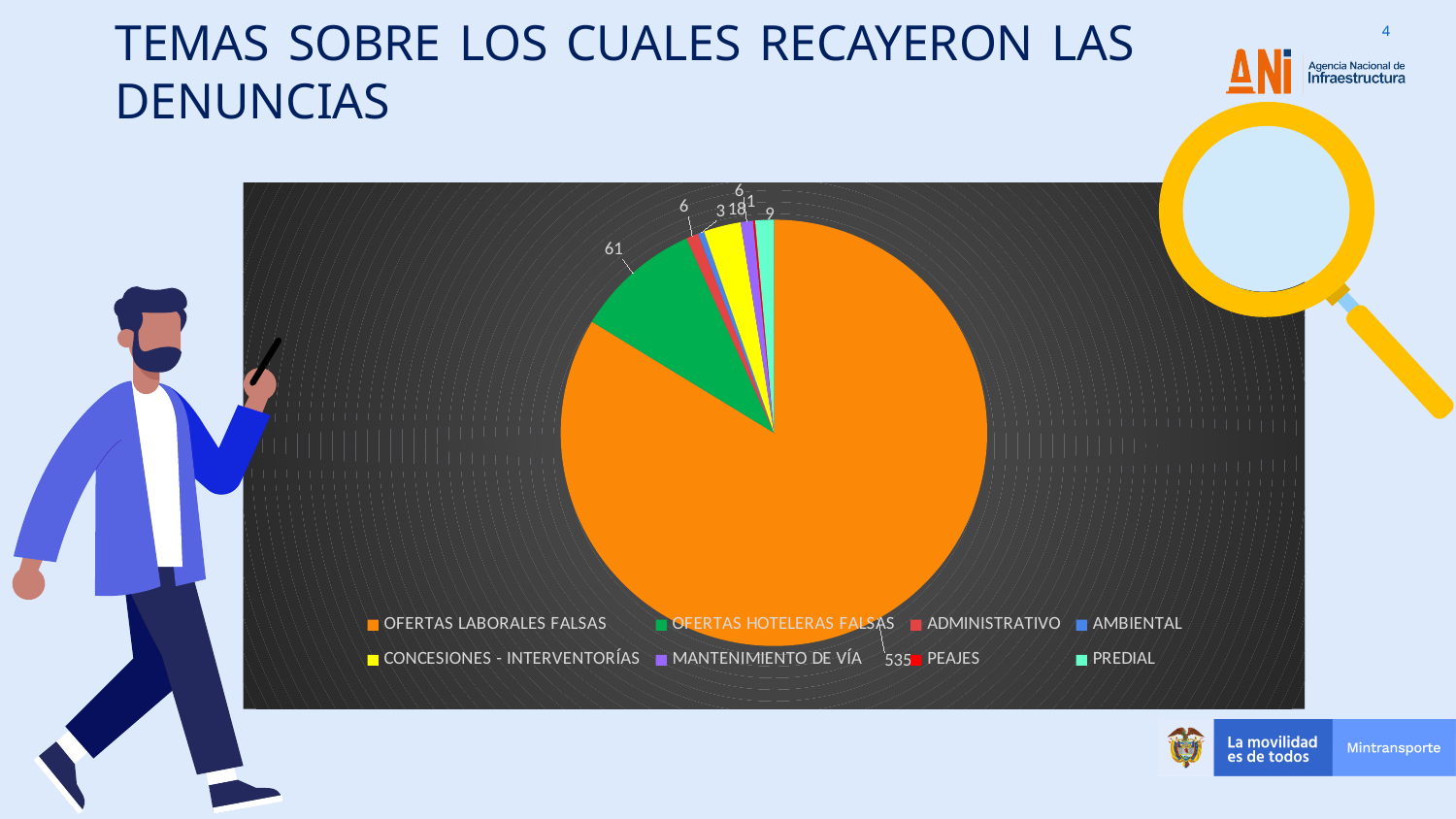
How many categories does the legend of the pie chart list? 8 What is the value for PREDIAL? 9 Which category has the smallest value in the pie chart? PEAJES What is the difference between the values for OFERTAS LABORALES FALSAS and OFERTAS HOTELERAS FALSAS? 474 What kind of chart is shown on the slide? pie chart Which is larger, the value for OFERTAS HOTELERAS FALSAS or the value for CONCESIONES - INTERVENTORÍAS? OFERTAS HOTELERAS FALSAS What is the value for OFERTAS LABORALES FALSAS? 535 What colour is the slice for OFERTAS LABORALES FALSAS? orange What is the value for OFERTAS HOTELERAS FALSAS? 61 What is the title of the slide containing the pie chart? TEMAS SOBRE LOS CUALES RECAYERON LAS DENUNCIAS Which category has the largest slice of the pie? OFERTAS LABORALES FALSAS What is the value for CONCESIONES - INTERVENTORÍAS? 18